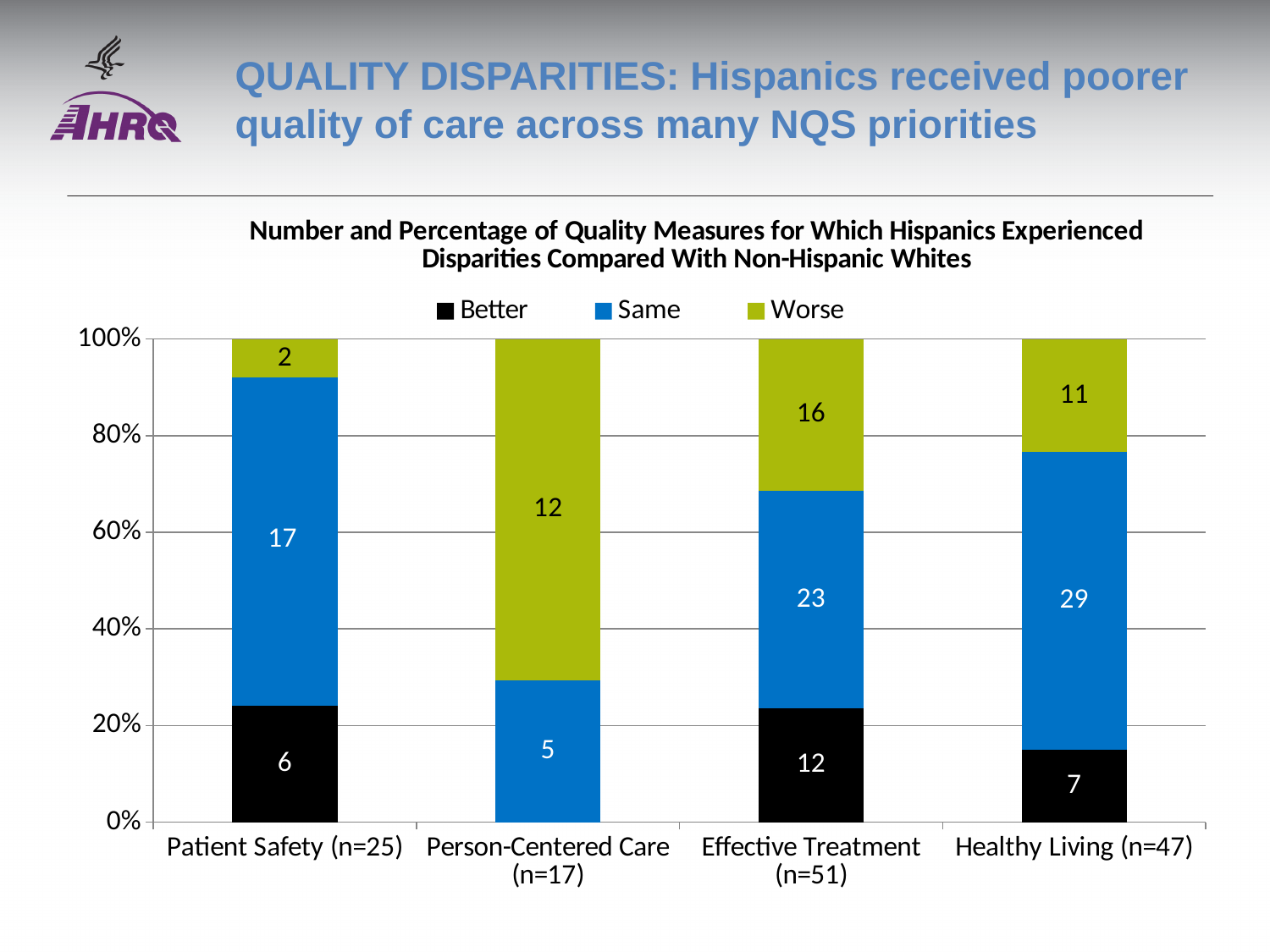
Is the Worse share for Person-Centered Care (n=17) greater or less than 60%? greater Which is larger: the Better measures for Patient Safety (n=25) or for Healthy Living (n=47)? Healthy Living (n=47) How many series does the legend list? 3 What is the number of Same measures for Healthy Living (n=47)? 29 Which category has the highest number of Worse measures? Effective Treatment (n=51) What kind of chart is shown on the slide? Stacked bar chart What is the number of Worse measures for Person-Centered Care (n=17)? 12 What is the number of Same measures for Patient Safety (n=25)? 17 What is the number of Better measures for Effective Treatment (n=51)? 12 Which category has the lowest number of Worse measures? Patient Safety (n=25) How many categories are shown on the x axis? 4 What is the difference between the Same measures for Healthy Living (n=47) and Effective Treatment (n=51)? 6